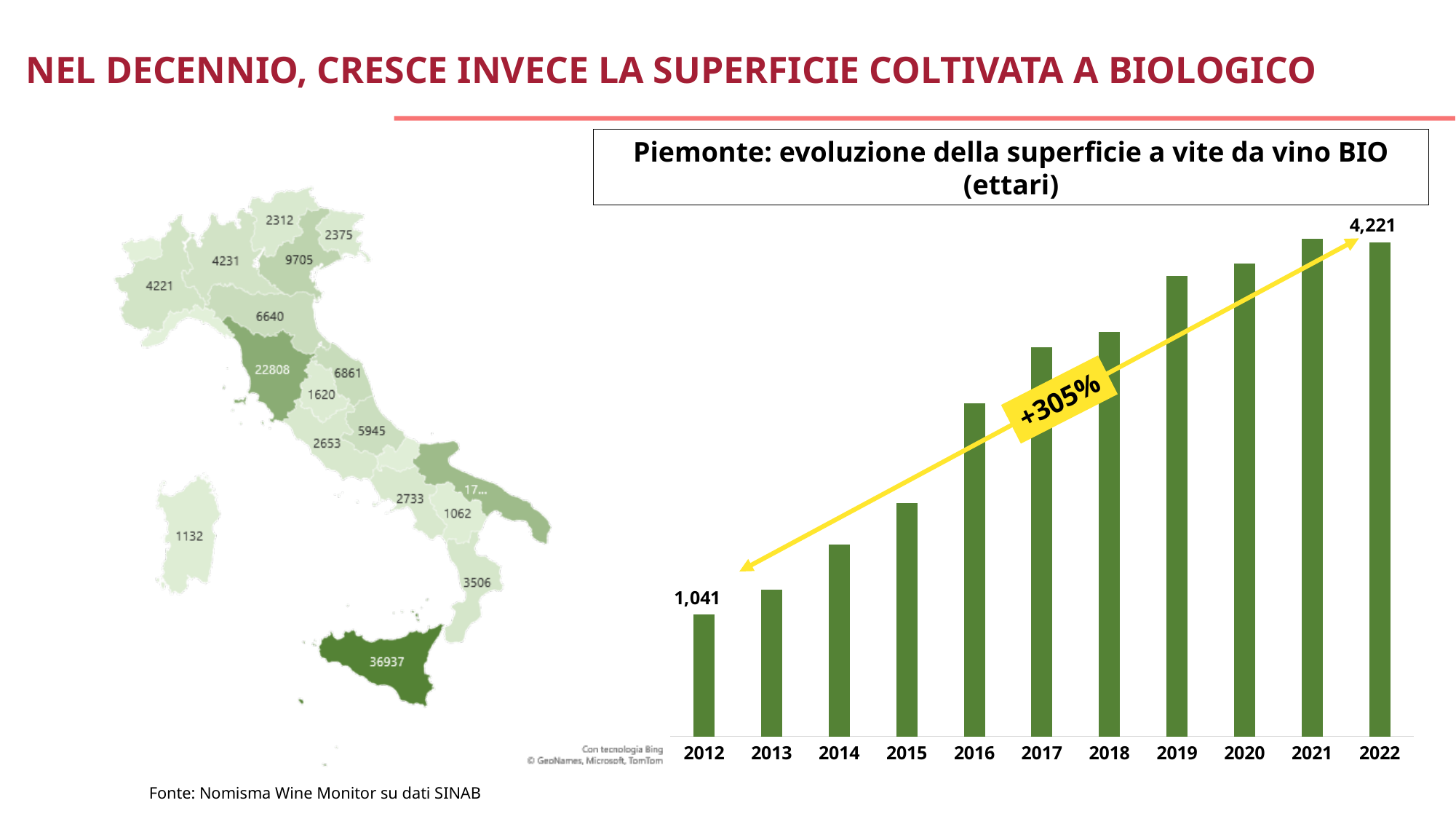
On the map of Italy on the left, what is the highest value shown for a region? 36937 In the Piemonte bar chart, do the values generally rise or fall from 2012 to 2022? rise In the Piemonte bar chart, what is the difference between the 2022 value and the 2012 value? 3,180 In the Piemonte bar chart, what is the value for 2012? 1,041 In the Piemonte bar chart, which year has the lowest value? 2012 What percentage growth is shown on the yellow arrow in the Piemonte bar chart? +305% What unit is given in the title of the Piemonte bar chart? ettari In the Piemonte bar chart, which is larger, the value for 2016 or the value for 2015? 2016 What type of chart is the 'Piemonte: evoluzione della superficie a vite da vino BIO (ettari)' chart? bar chart In the Piemonte bar chart, which is larger, the value for 2019 or the value for 2018? 2019 In the Piemonte bar chart, what is the value for 2022? 4,221 How many years are shown on the x axis of the Piemonte bar chart? 11